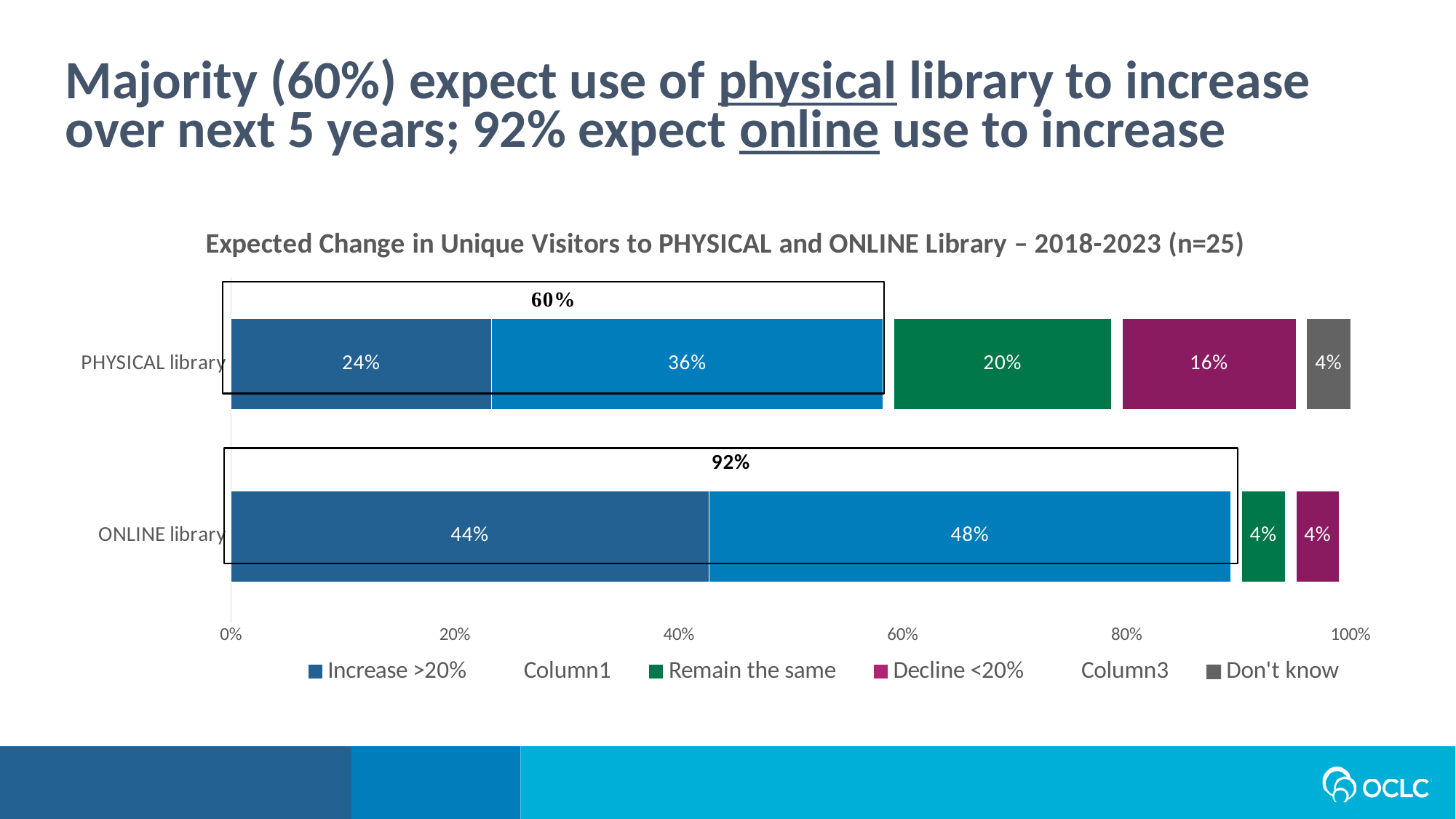
What kind of chart is shown on the slide? Stacked bar chart What percentage of respondents expect an 'Increase >20%' in unique visitors to the ONLINE library? 44% What is the 'Remain the same' value for the PHYSICAL library? 20% How many entries does the chart legend list? 6 How many library categories are plotted on the chart? 2 What combined percentage is bracketed above the ONLINE library bar? 92% What percentage of respondents expect an 'Increase >20%' in unique visitors to the PHYSICAL library? 24% How much larger is the 'Increase >20%' value for the ONLINE library than for the PHYSICAL library? 20 percentage points What is the 'Decline <20%' value for the PHYSICAL library? 16% What is the 'Don't know' value for the PHYSICAL library? 4% Which library has the larger 'Remain the same' value, PHYSICAL or ONLINE? PHYSICAL library What is the total of all segments in the PHYSICAL library bar? 100%